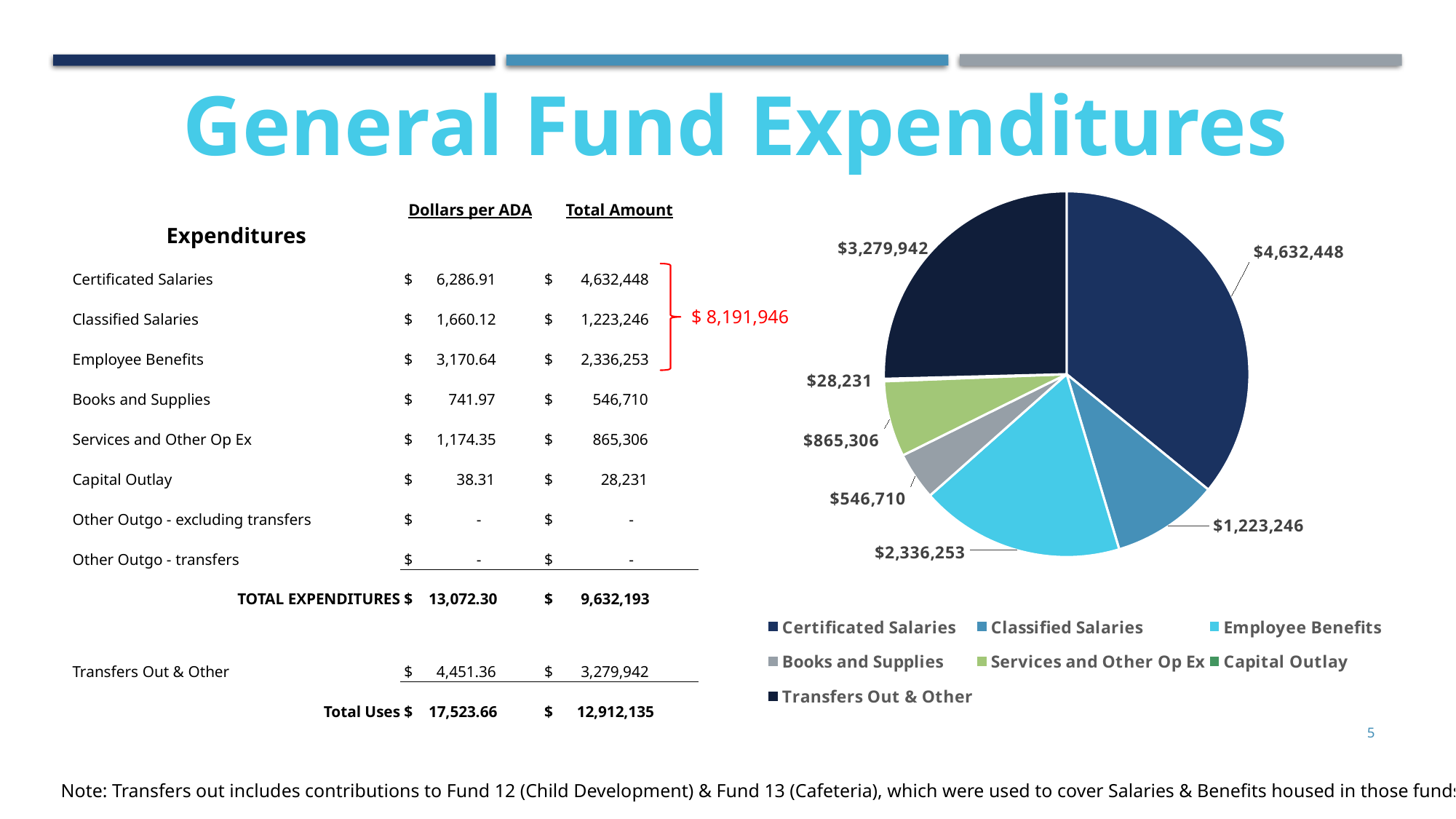
In the pie chart, what is the value labelled for Transfers Out & Other? $3,279,942 In the pie chart, what is the value labelled for Capital Outlay? $28,231 In the pie chart, which is larger: Employee Benefits or Classified Salaries? Employee Benefits In the pie chart, what is the difference between the Services and Other Op Ex value and the Books and Supplies value? $318,596 What kind of chart is shown on the right side of the slide? Pie chart How many slices does the pie chart have? 7 How many entries does the pie chart's legend list? 7 Which category has the largest slice in the pie chart? Certificated Salaries In the pie chart, what is the value labelled for Employee Benefits? $2,336,253 Which category has the smallest slice in the pie chart? Capital Outlay In the pie chart, what is the value labelled for Certificated Salaries? $4,632,448 In the pie chart, what is the difference between the Certificated Salaries value and the Transfers Out & Other value? $1,352,506